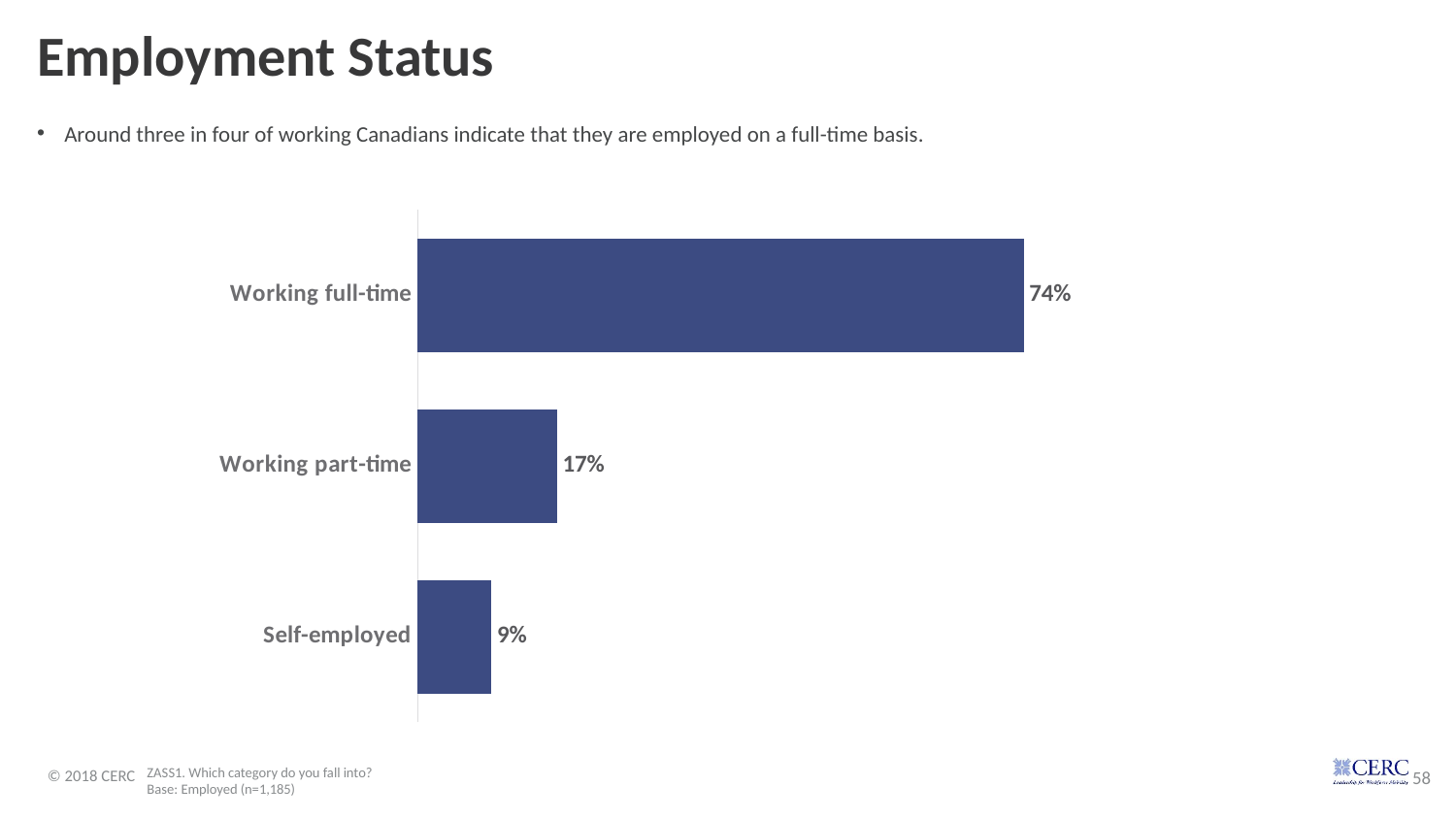
What is the total of the three percentages shown in the chart? 100% Which employment category has the lowest percentage? Self-employed What is the title of the slide containing the chart? Employment Status What type of chart is shown on the slide? Bar chart What percentage of respondents are working full-time? 74% What percentage of respondents are self-employed? 9% What is the difference in percentage points between working full-time and working part-time? 57 What percentage of respondents are working part-time? 17% Which is larger, the percentage working part-time or the percentage self-employed? Working part-time How many employment categories are shown in the chart? 3 What is the difference in percentage points between working part-time and self-employed? 8 Which employment category has the highest percentage? Working full-time